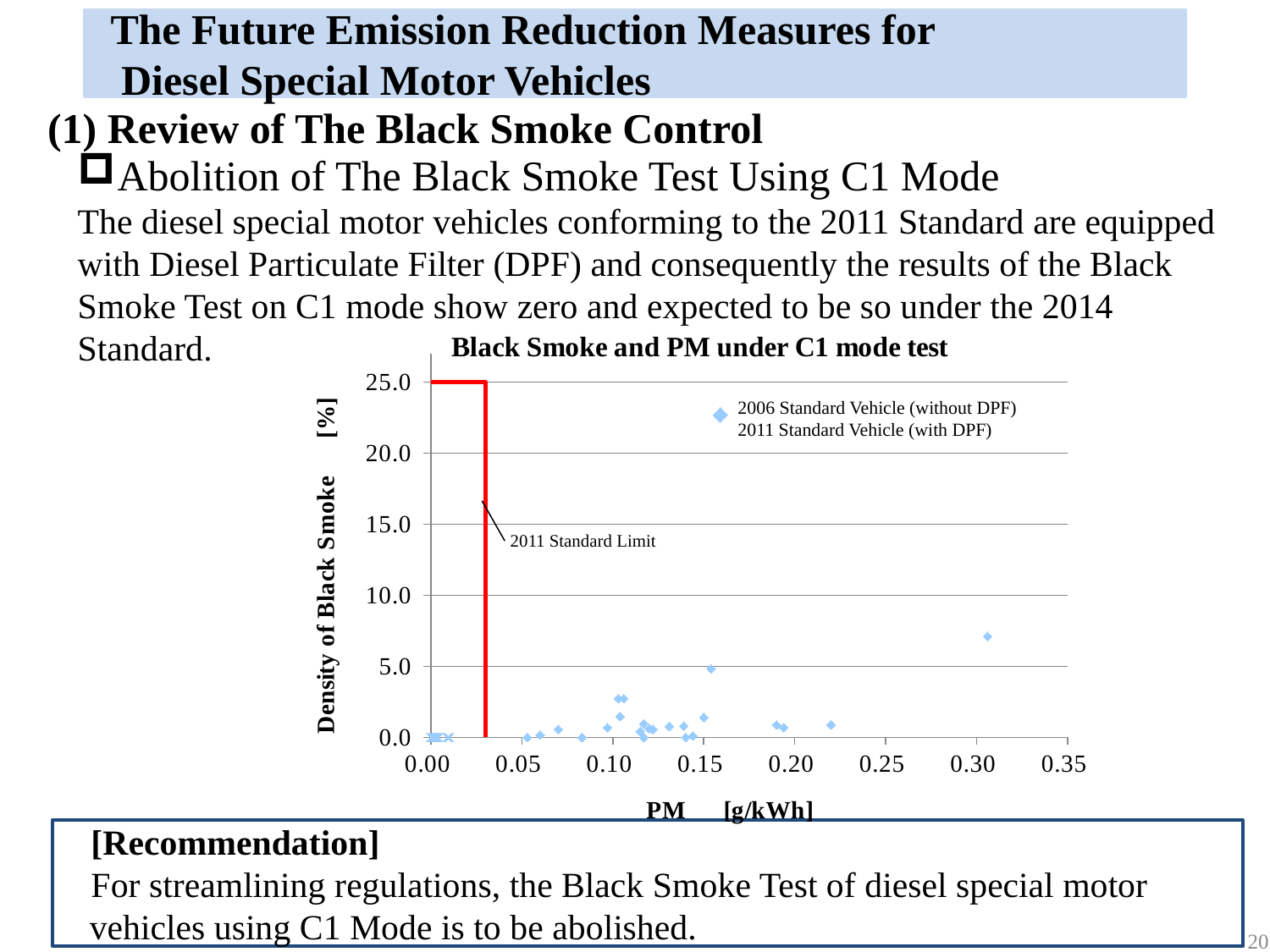
What kind of chart is shown on the slide? scatter chart What does the red line on the chart represent? 2011 Standard Limit How many plotted points have a Density of Black Smoke above 10.0%? 0 Is the Density of Black Smoke for the point near PM 0.155 g/kWh greater or less than 10.0? less Are the plotted points with PM below 0.03 g/kWh greater or less than 5.0% Density of Black Smoke? less What is the title of the chart? Black Smoke and PM under C1 mode test How many series does the chart legend list? 2 Is the highest plotted Density of Black Smoke value greater or less than 10.0? less